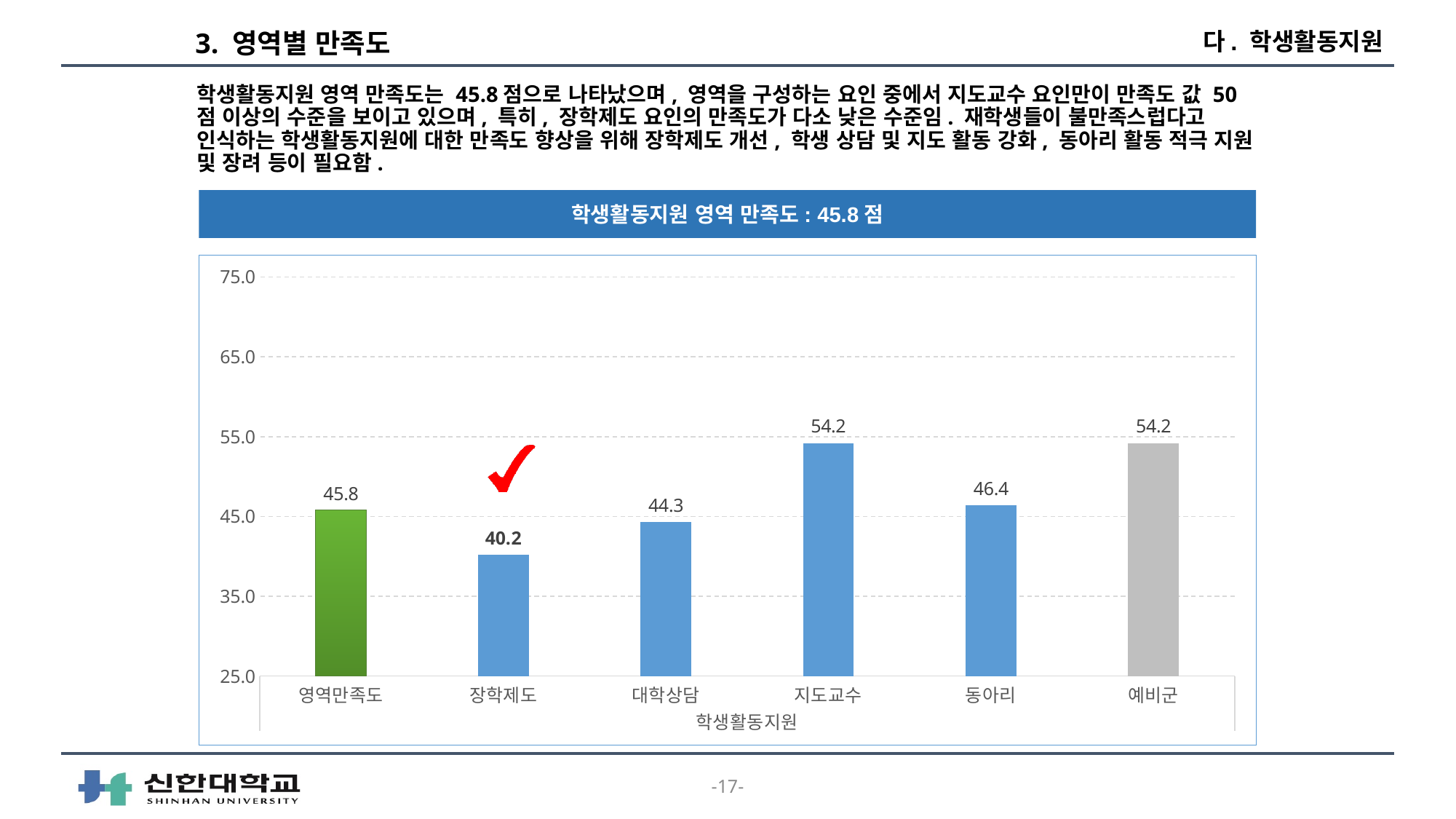
Which category has the lowest value? 장학제도 What is the difference between the values for 지도교수 and 장학제도? 14.0 What is the value for 장학제도? 40.2 Which is larger, the value for 동아리 or the value for 대학상담? 동아리 How many categories are shown on the x axis? 6 What is the value for 영역만족도? 45.8 What is the difference between the values for 동아리 and 대학상담? 2.1 What is the value for 대학상담? 44.3 Is the value for 예비군 greater or less than 45.0? greater What is the x-axis title of the chart? 학생활동지원 What is the value for 동아리? 46.4 What kind of chart is shown on the slide? bar chart